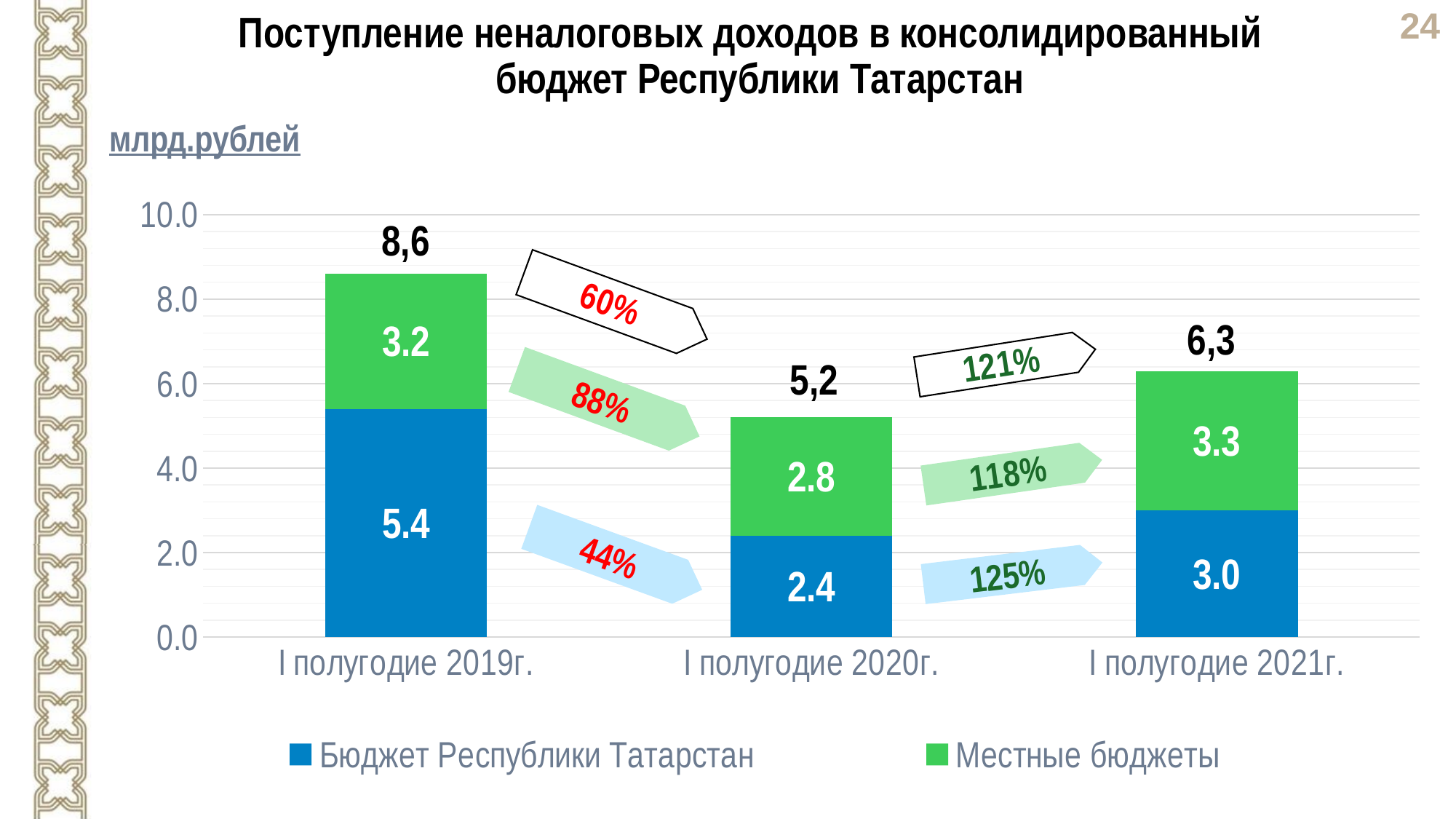
What kind of chart is shown on the slide? Stacked bar chart What is the value for Бюджет Республики Татарстан in I полугодие 2021г.? 3.0 What is the total of the stacked bar for I полугодие 2019г.? 8,6 What is the value for Местные бюджеты in I полугодие 2020г.? 2.8 What is the difference between the Бюджет Республики Татарстан values for I полугодие 2019г. and I полугодие 2020г.? 3.0 What is the total of the stacked bar for I полугодие 2021г.? 6,3 Which period has the highest value for Бюджет Республики Татарстан? I полугодие 2019г. How many periods are shown on the x axis? 3 Which is larger in I полугодие 2021г.: Бюджет Республики Татарстан or Местные бюджеты? Местные бюджеты Which period has the lowest total non-tax revenue? I полугодие 2020г. What is the value for Бюджет Республики Татарстан in I полугодие 2019г.? 5.4 How many series does the legend list? 2